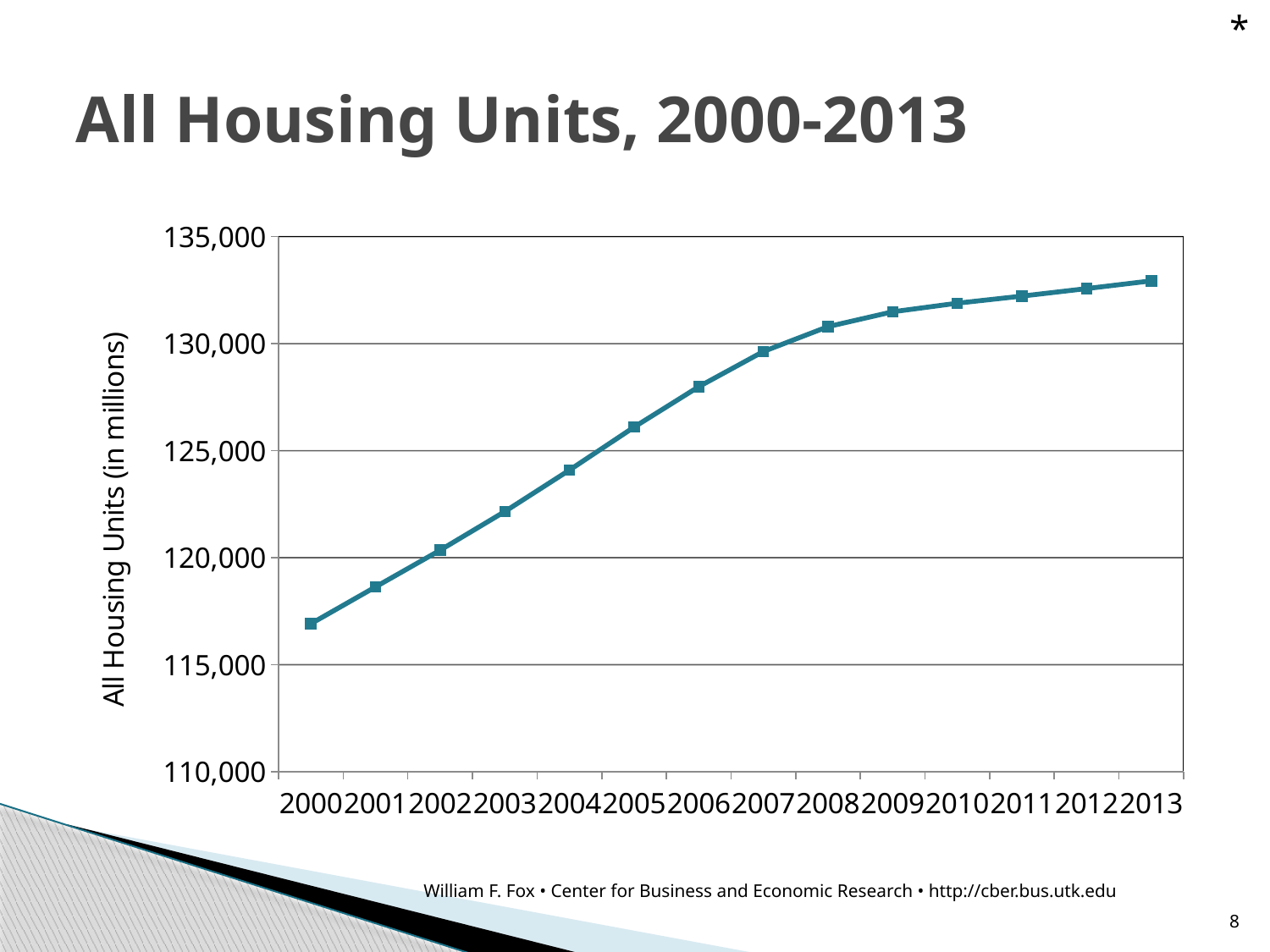
How many years are plotted on the chart? 14 Which year has more housing units, 2005 or 2010? 2010 Is the value for 2005 greater or less than 125,000? greater What kind of chart is shown on the slide? line chart Which year has the lowest number of housing units? 2000 What is the label on the vertical axis? All Housing Units (in millions) Is the value for 2000 greater or less than 120,000? less Is the value for 2003 greater or less than 125,000? less Do the values rise or fall from 2000 to 2013? rise Which year has the highest number of housing units? 2013